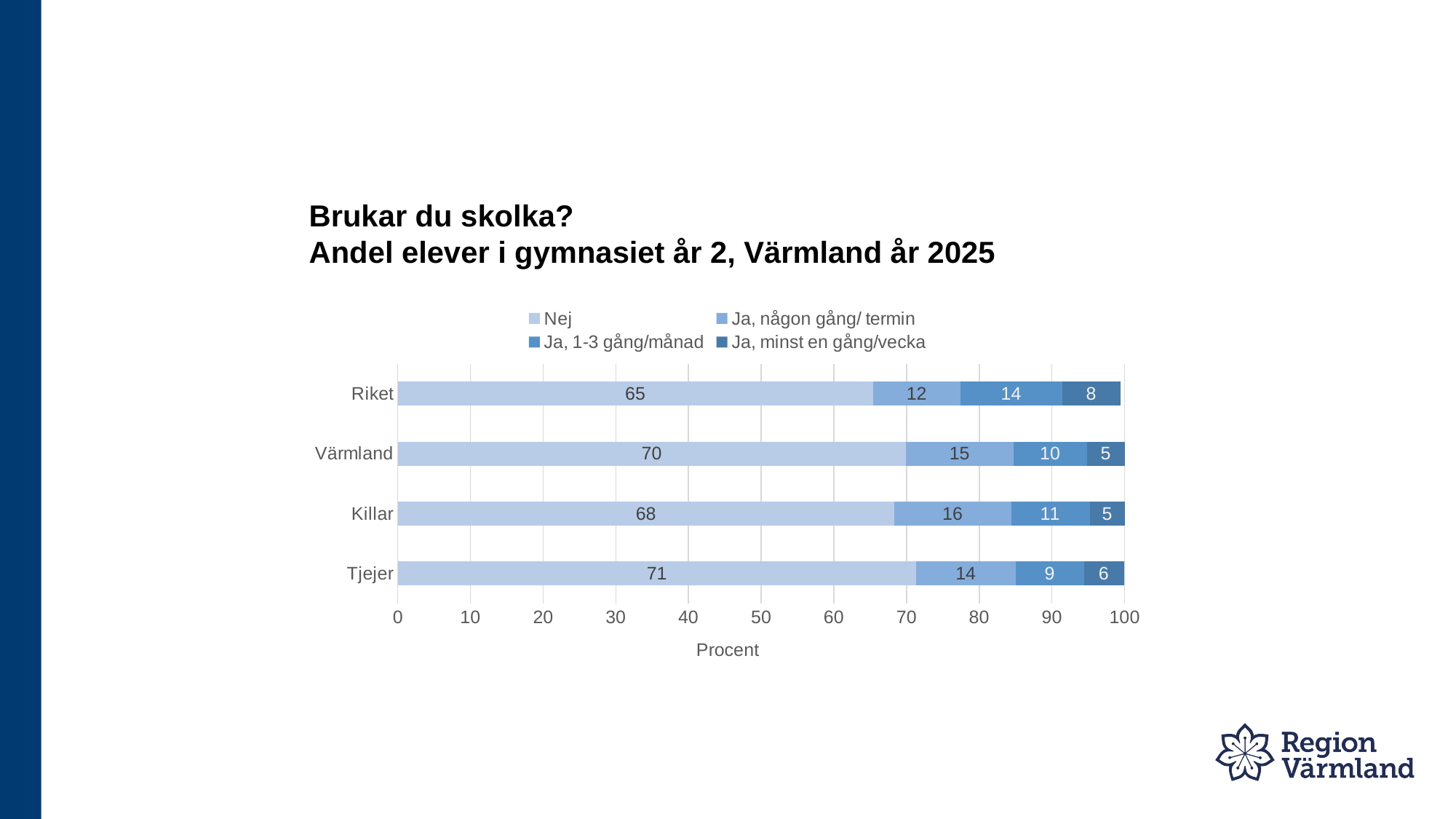
What is the difference between the 'Nej' values for Tjejer and Riket? 6 Which is larger: the 'Ja, minst en gång/vecka' value for Riket or for Värmland? Riket What is the label of the horizontal axis? Procent How many categories are shown on the vertical axis? 4 Which category has the lowest value for 'Ja, 1-3 gång/månad'? Tjejer Which category has the highest value for 'Nej'? Tjejer What is the value for 'Ja, någon gång/ termin' for Killar? 16 What is the value for 'Ja, minst en gång/vecka' for Tjejer? 6 What kind of chart is shown on the slide? Stacked bar chart What is the value for 'Nej' for Riket? 65 How many series does the legend list? 4 What is the total of the stacked bar for Riket? 99